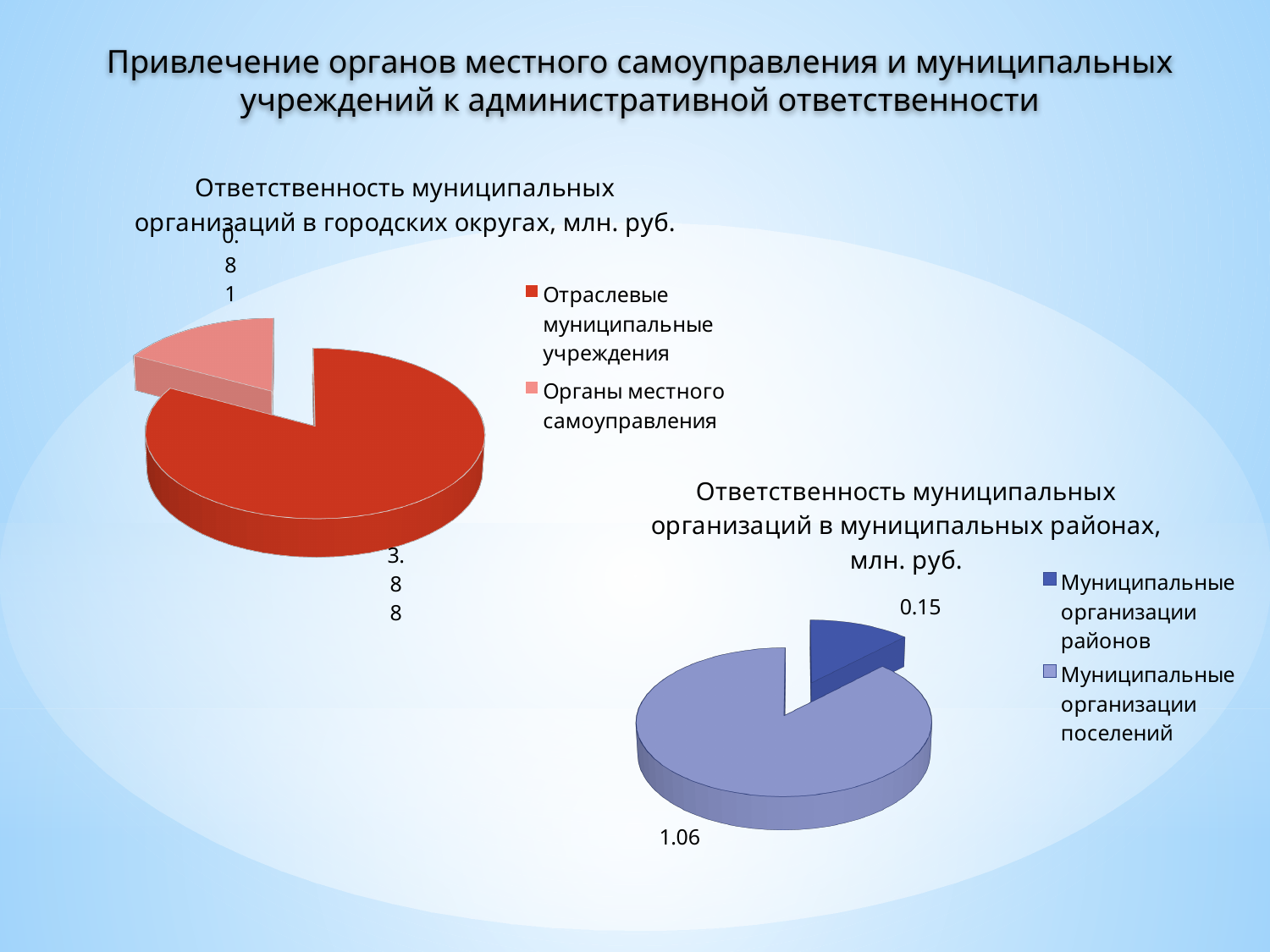
How many pie charts are shown on the slide? 2 In the chart 'Ответственность муниципальных организаций в муниципальных районах, млн. руб.', what is the value for 'Муниципальные организации поселений'? 1.06 In the chart 'Ответственность муниципальных организаций в муниципальных районах, млн. руб.', which category has the smallest slice? Муниципальные организации районов In the chart 'Ответственность муниципальных организаций в муниципальных районах, млн. руб.', what is the difference between the values for 'Муниципальные организации поселений' and 'Муниципальные организации районов'? 0.91 In the chart 'Ответственность муниципальных организаций в городских округах, млн. руб.', what is the value for 'Органы местного самоуправления'? 0.81 In the chart 'Ответственность муниципальных организаций в городских округах, млн. руб.', what is the value for 'Отраслевые муниципальные учреждения'? 3.88 In the chart 'Ответственность муниципальных организаций в муниципальных районах, млн. руб.', which is larger: 'Муниципальные организации районов' or 'Муниципальные организации поселений'? Муниципальные организации поселений In the chart 'Ответственность муниципальных организаций в городских округах, млн. руб.', which category has the largest slice? Отраслевые муниципальные учреждения In the chart 'Ответственность муниципальных организаций в муниципальных районах, млн. руб.', what is the value for 'Муниципальные организации районов'? 0.15 In the chart 'Ответственность муниципальных организаций в городских округах, млн. руб.', what is the difference between the values for 'Отраслевые муниципальные учреждения' and 'Органы местного самоуправления'? 3.07 In the chart 'Ответственность муниципальных организаций в городских округах, млн. руб.', how many categories does the legend list? 2 What type of chart is used for 'Ответственность муниципальных организаций в городских округах, млн. руб.'? Pie chart